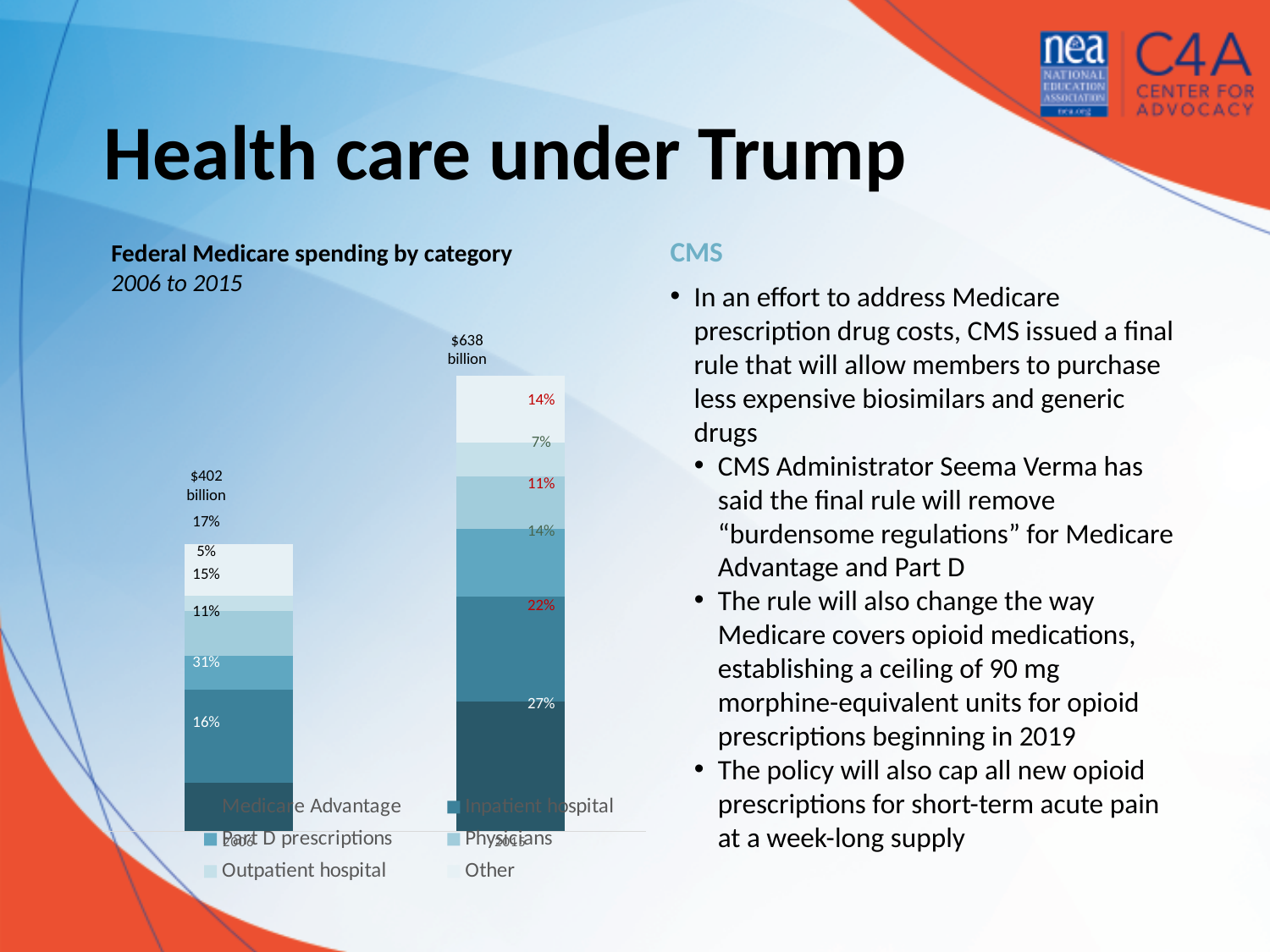
How many spending categories does the legend list? 6 What is the smallest percentage segment in the 2006 bar? 5% What is the largest percentage segment in the 2015 bar? 27% What is the total Federal Medicare spending shown for 2006? $402 billion What kind of chart is shown on the slide? Stacked bar chart What is the total Federal Medicare spending shown for 2015? $638 billion By how much did total Federal Medicare spending increase from 2006 to 2015? $236 billion Which year has the larger total Medicare spending, 2006 or 2015? 2015 What is the title of the chart? Federal Medicare spending by category How many years (bars) are plotted in the chart? 2 What is the smallest percentage segment in the 2015 bar? 7% What is the largest percentage segment in the 2006 bar? 31%